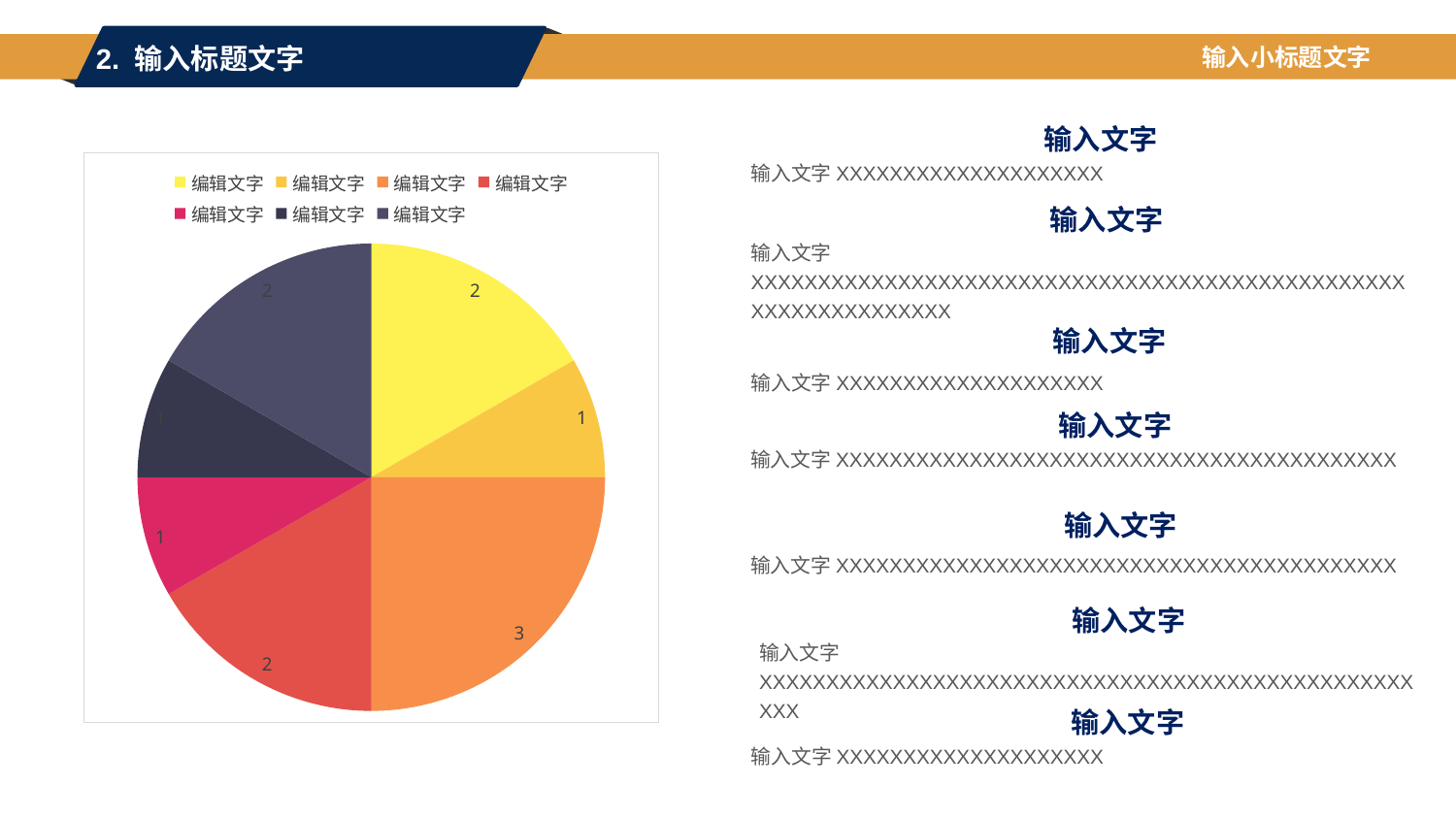
How many slices in the pie chart are labelled with the value 1? 3 How many entries does the pie chart's legend list? 7 What share of the pie does the slice labelled 3 represent? 25% How many slices does the pie chart have? 7 What is the total of all the slice values in the pie chart? 12 What value is shown on the orange slice of the pie chart? 3 What is the smallest value shown on any slice of the pie chart? 1 What text is used for every entry in the pie chart's legend? 编辑文字 How many slices in the pie chart are labelled with the value 2? 3 What is the value shown on the largest slice of the pie chart? 3 What is the difference between the largest slice value and the smallest slice value in the pie chart? 2 What kind of chart is shown on the slide? pie chart